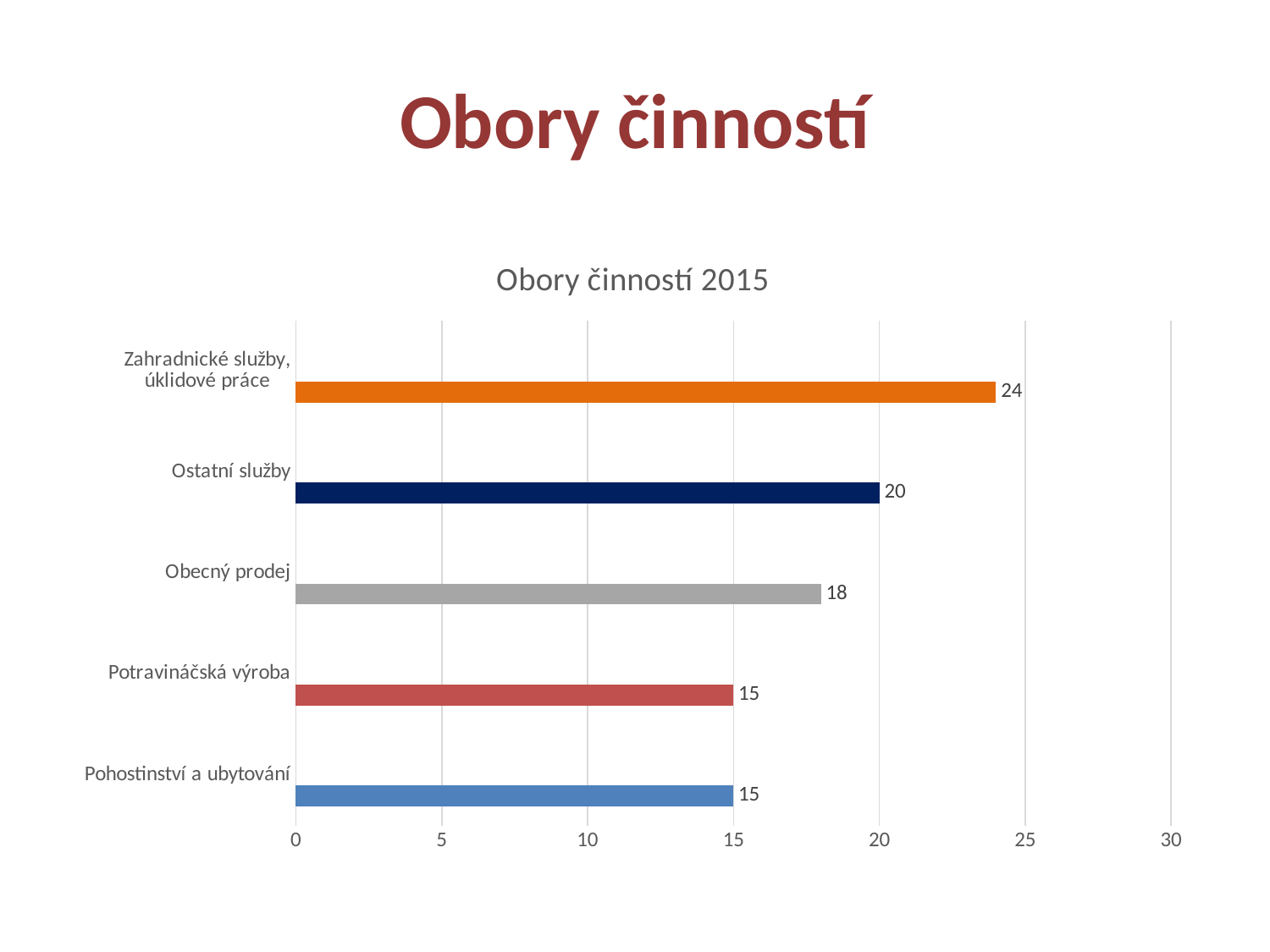
How many categories are shown in the chart? 5 Is the value for Obecný prodej greater or less than 20? less What is the title of the chart? Obory činností 2015 What is the difference between the values for Zahradnické služby, úklidové práce and Ostatní služby? 4 What kind of chart is shown on the slide? bar chart What is the value for Obecný prodej? 18 What is the value for Ostatní služby? 20 Which is larger, the value for Ostatní služby or the value for Obecný prodej? Ostatní služby Which category has the highest value? Zahradnické služby, úklidové práce What is the value for Zahradnické služby, úklidové práce? 24 What is the value for Pohostinství a ubytování? 15 What is the difference between the values for Obecný prodej and Potravinářská výroba? 3